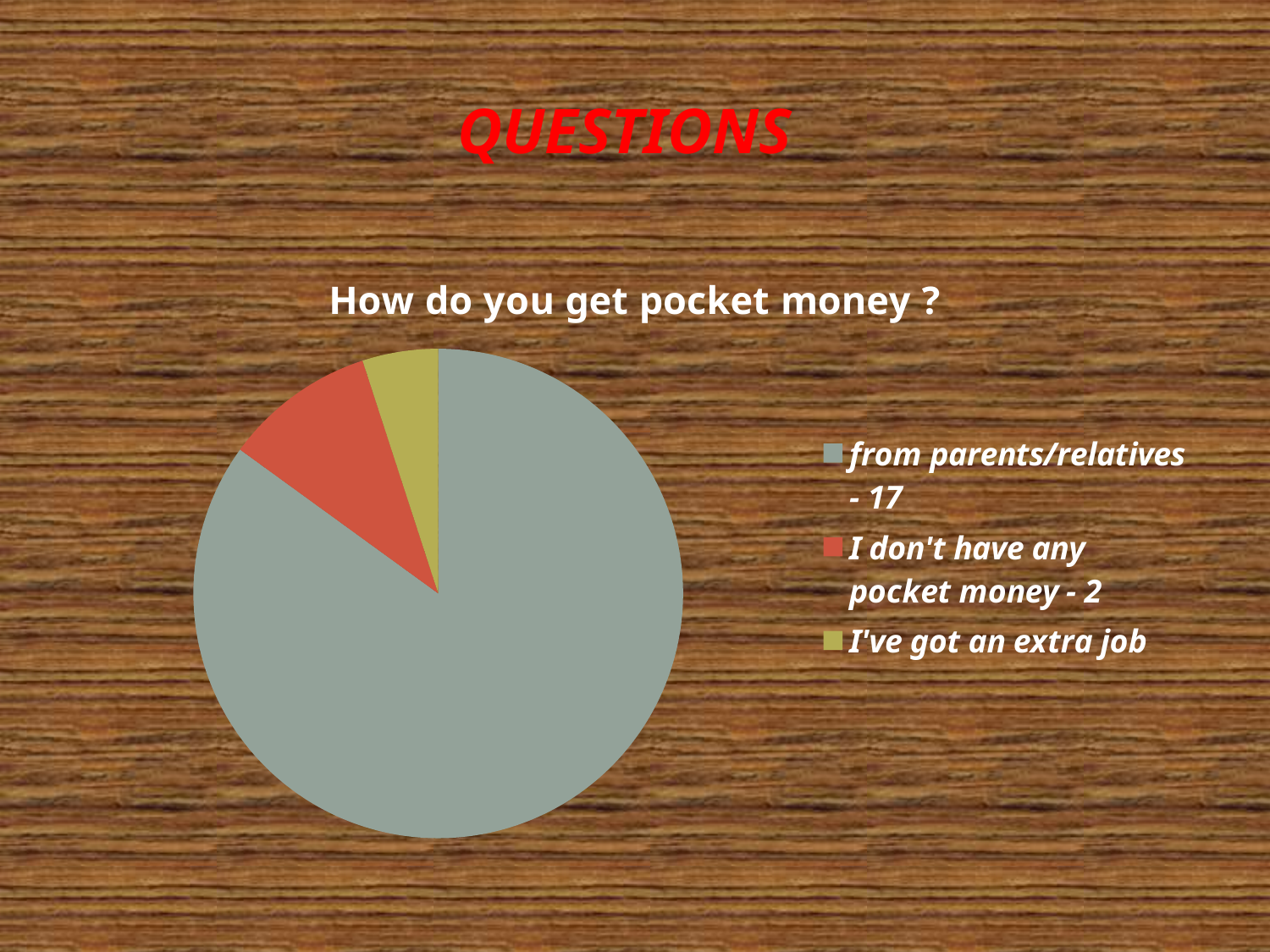
How many categories does the pie chart have? 3 What value is given in the legend for "from parents/relatives"? 17 What value is given in the legend for "I don't have any pocket money"? 2 What is the title of the chart? How do you get pocket money ? What kind of chart is shown on the slide? pie chart Which category has the largest slice of the pie? from parents/relatives Which slice is larger: "I don't have any pocket money" or "I've got an extra job"? I don't have any pocket money What is the difference between the values for "from parents/relatives" and "I don't have any pocket money"? 15 What colour is the slice for "I don't have any pocket money"? red Which category has the smallest slice of the pie? I've got an extra job